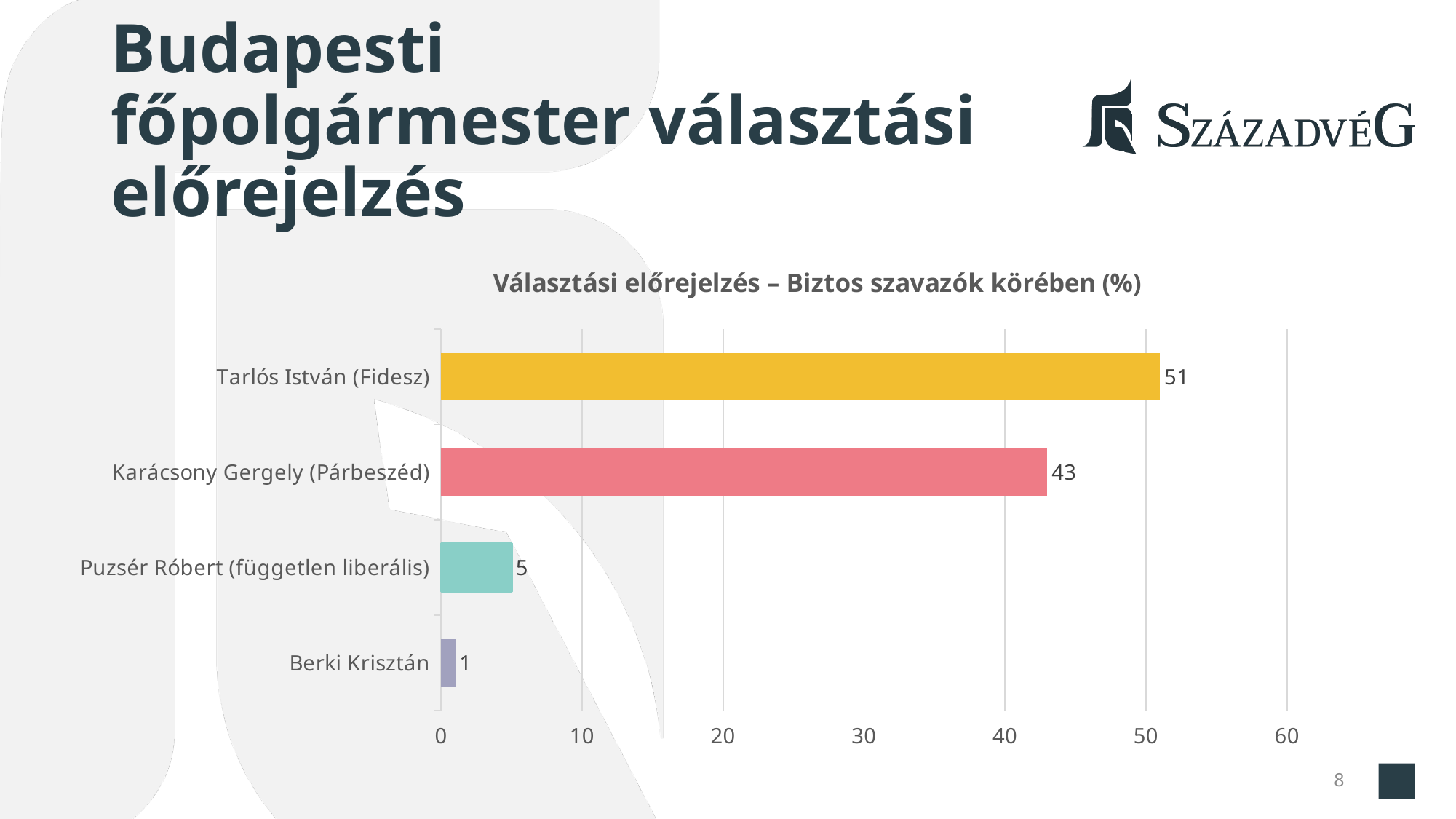
What is the value for Karácsony Gergely (Párbeszéd)? 43 Is the value for Karácsony Gergely (Párbeszéd) greater or less than 50? less Which candidate has the highest value? Tarlós István (Fidesz) Which candidate has the lowest value? Berki Krisztán What is the value for Berki Krisztán? 1 What is the difference between the values for Tarlós István (Fidesz) and Karácsony Gergely (Párbeszéd)? 8 What kind of chart is shown on the slide? bar chart What is the title of the chart? Választási előrejelzés – Biztos szavazók körében (%) How many candidates are shown in the chart? 4 What is the value for Puzsér Róbert (független liberális)? 5 Which is larger, the value for Puzsér Róbert (független liberális) or the value for Berki Krisztán? Puzsér Róbert (független liberális) What is the value for Tarlós István (Fidesz)? 51